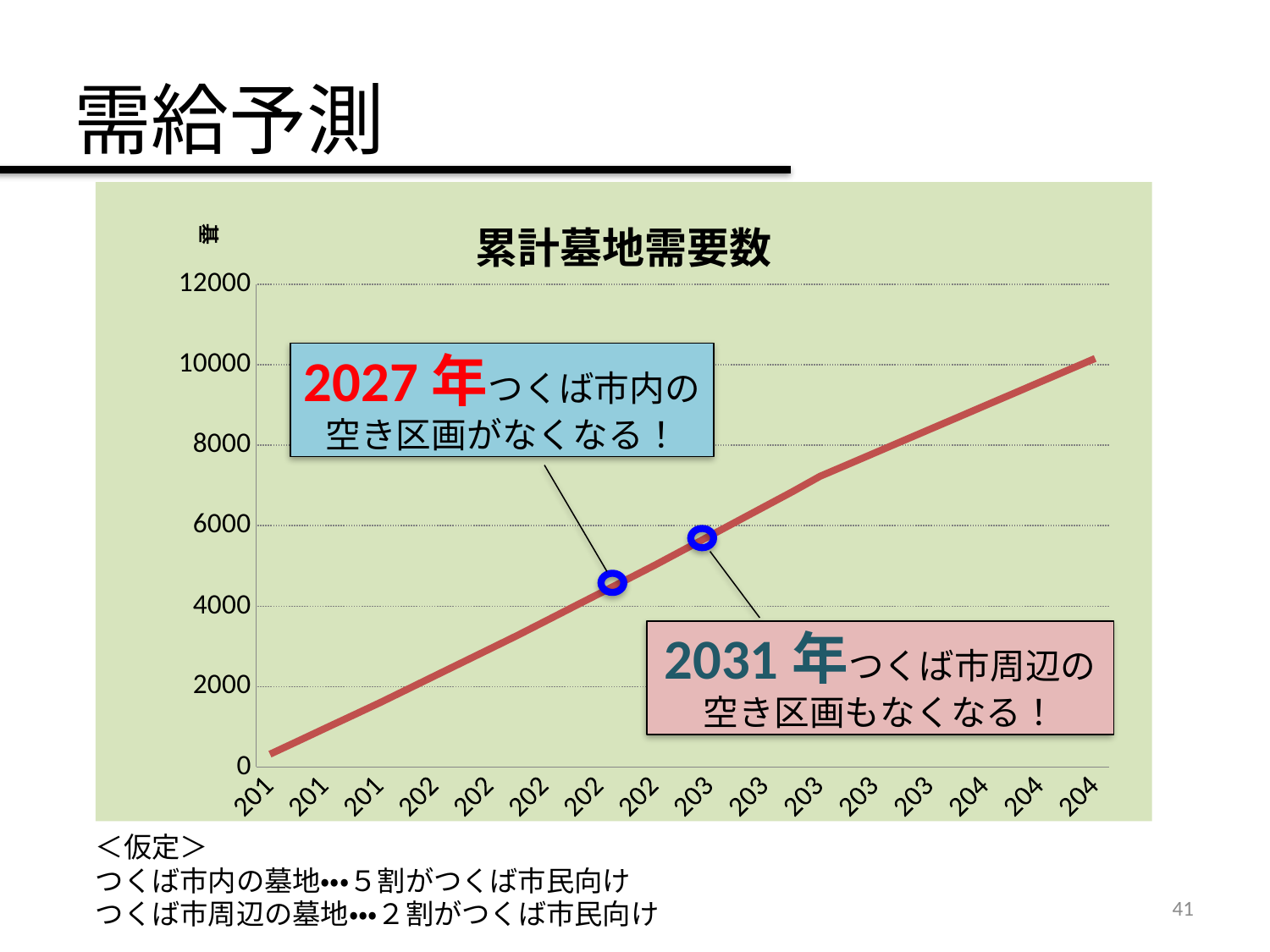
Is the value at the point marked 2031年 greater or less than 4000? greater Is the value at the leftmost point of the line greater or less than 2000? less Is the value at the point marked 2027年 greater or less than 4000? greater How many category labels are shown along the x axis of the chart? 16 What kind of chart is shown on the slide? line chart What is the title of the chart? 累計墓地需要数 What is the highest tick value shown on the y axis? 12000 Do the values of the line rise or fall from left to right along the x axis? rise Which marked point has the larger value, the one labelled 2027年 or the one labelled 2031年? 2031年